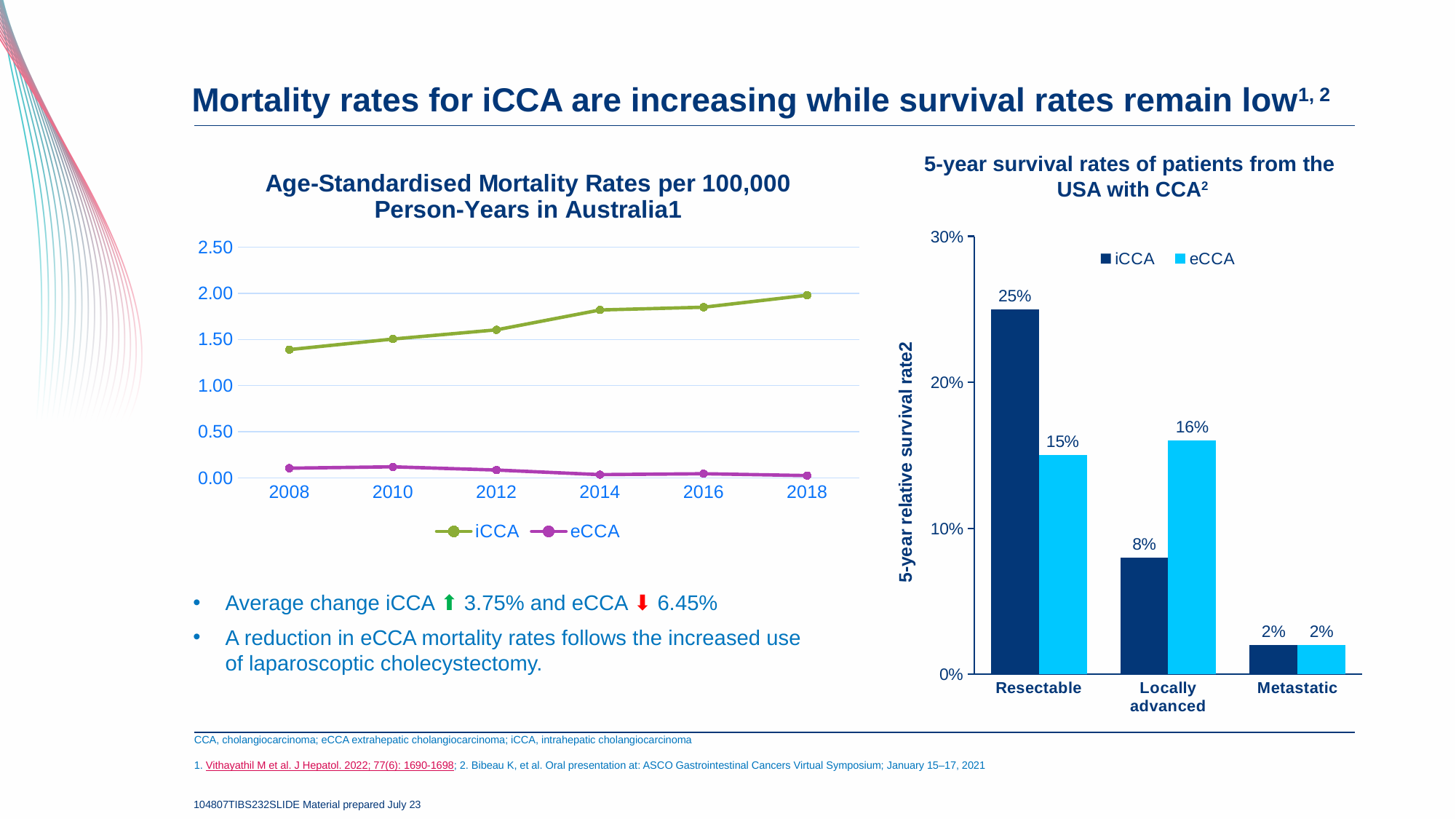
In the 5-year survival rates chart on the right, what is the difference between the iCCA and eCCA survival rates in the Resectable group? 10% In the 5-year survival rates chart on the right, what is the survival rate for eCCA in the Locally advanced group? 16% How many patient groups are shown on the x axis of the 5-year survival rates chart on the right? 3 What kind of chart is the Age-Standardised Mortality Rates chart on the left? Line chart What are the two series listed in the legend of the Age-Standardised Mortality Rates chart on the left? iCCA and eCCA In the 5-year survival rates chart on the right, what is the 5-year relative survival rate for iCCA in the Resectable group? 25% In the Age-Standardised Mortality Rates chart on the left, is the iCCA value for 2008 greater or less than 1.00? greater In the 5-year survival rates chart on the right, which series has the higher survival rate in the Locally advanced group, iCCA or eCCA? eCCA How many series does the legend of the 5-year survival rates chart on the right list? 2 In the 5-year survival rates chart on the right, which group has the highest iCCA survival rate? Resectable How many years are shown on the x axis of the Age-Standardised Mortality Rates chart on the left? 6 In the Age-Standardised Mortality Rates chart on the left, does the iCCA line rise or fall from 2008 to 2018? Rise